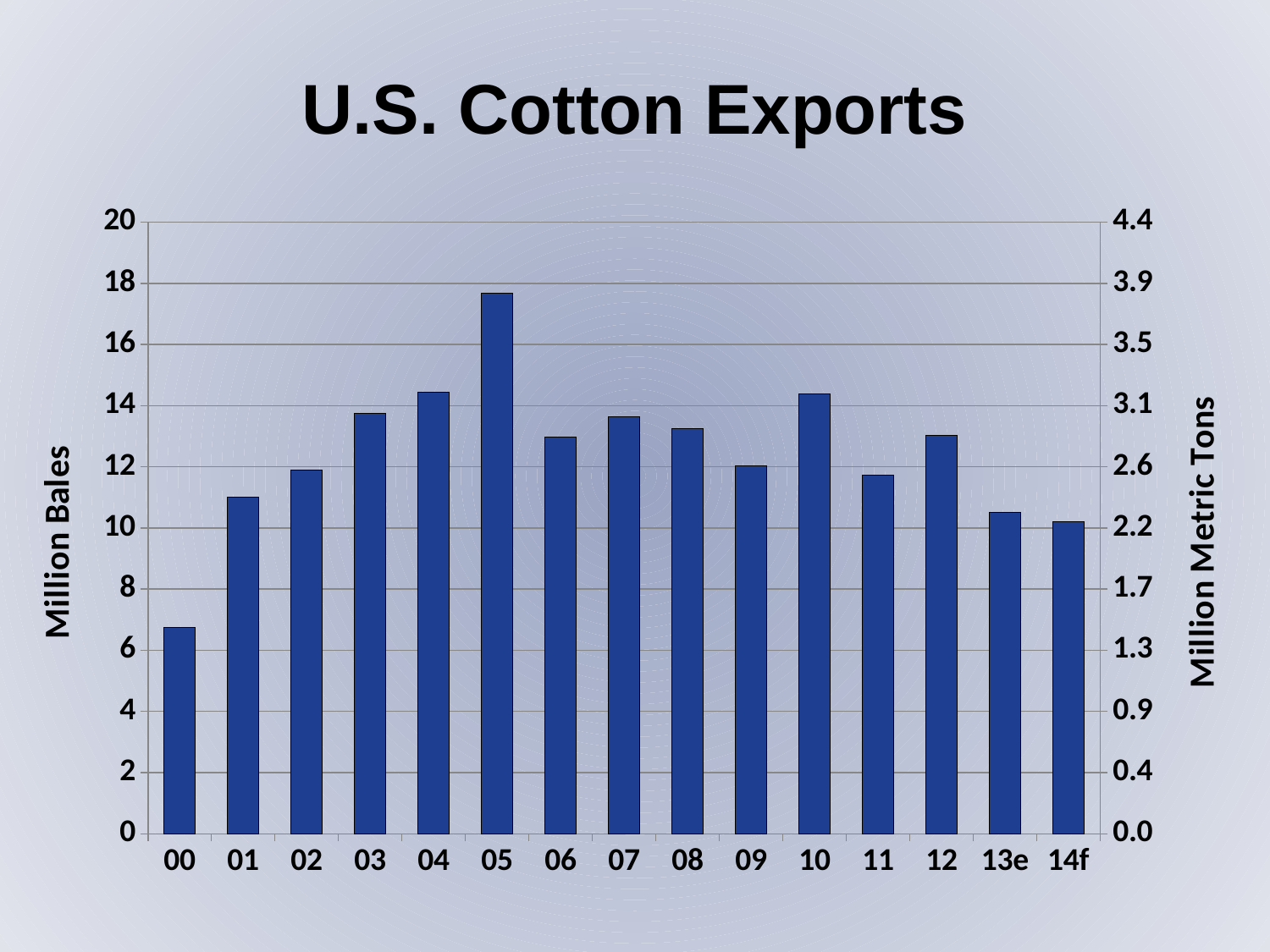
Is the value for 09 greater or less than 10 million bales? greater Is the value for 00 greater or less than 8 million bales? less Is the value for 06 greater or less than 14 million bales? less Do the values rise or fall from 00 to 05? rise What is the label of the left vertical axis? Million Bales What type of chart is shown on the slide? bar chart Which year has the lowest cotton exports? 00 How many years (categories) are shown on the x axis? 15 Which year has the highest cotton exports? 05 Which is larger, the value for 04 or the value for 05? 05 What is the title of the chart? U.S. Cotton Exports